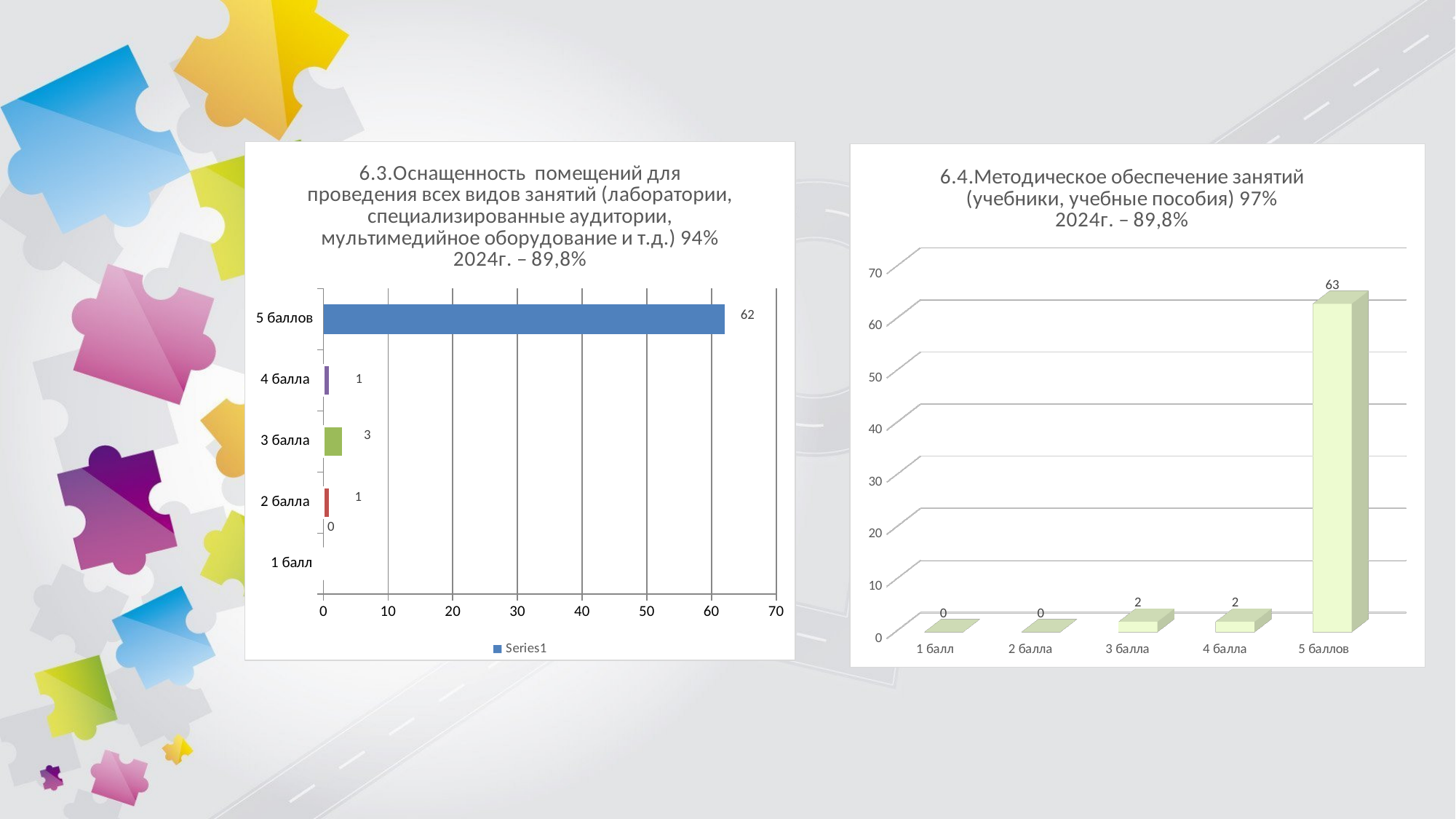
In the right chart (6.4), which is larger, the value for 3 балла or the value for 5 баллов? 5 баллов In the right chart (6.4), what is the value for 5 баллов? 63 In the left chart (6.3), what is the difference between the values for 5 баллов and 3 балла? 59 In the left chart (6.3), what kind of chart is shown? bar chart In the right chart (6.4), what is the difference between the values for 5 баллов and 4 балла? 61 In the left chart (6.3), how many categories are shown on the vertical axis? 5 In the left chart (6.3), which category has the lowest value? 1 балл In the left chart (6.3), what is the value for 5 баллов? 62 In the left chart (6.3), what is the legend entry? Series1 In the right chart (6.4), what is the value for 4 балла? 2 In the left chart (6.3), which category has the highest value? 5 баллов In the left chart (6.3), what is the value for 3 балла? 3